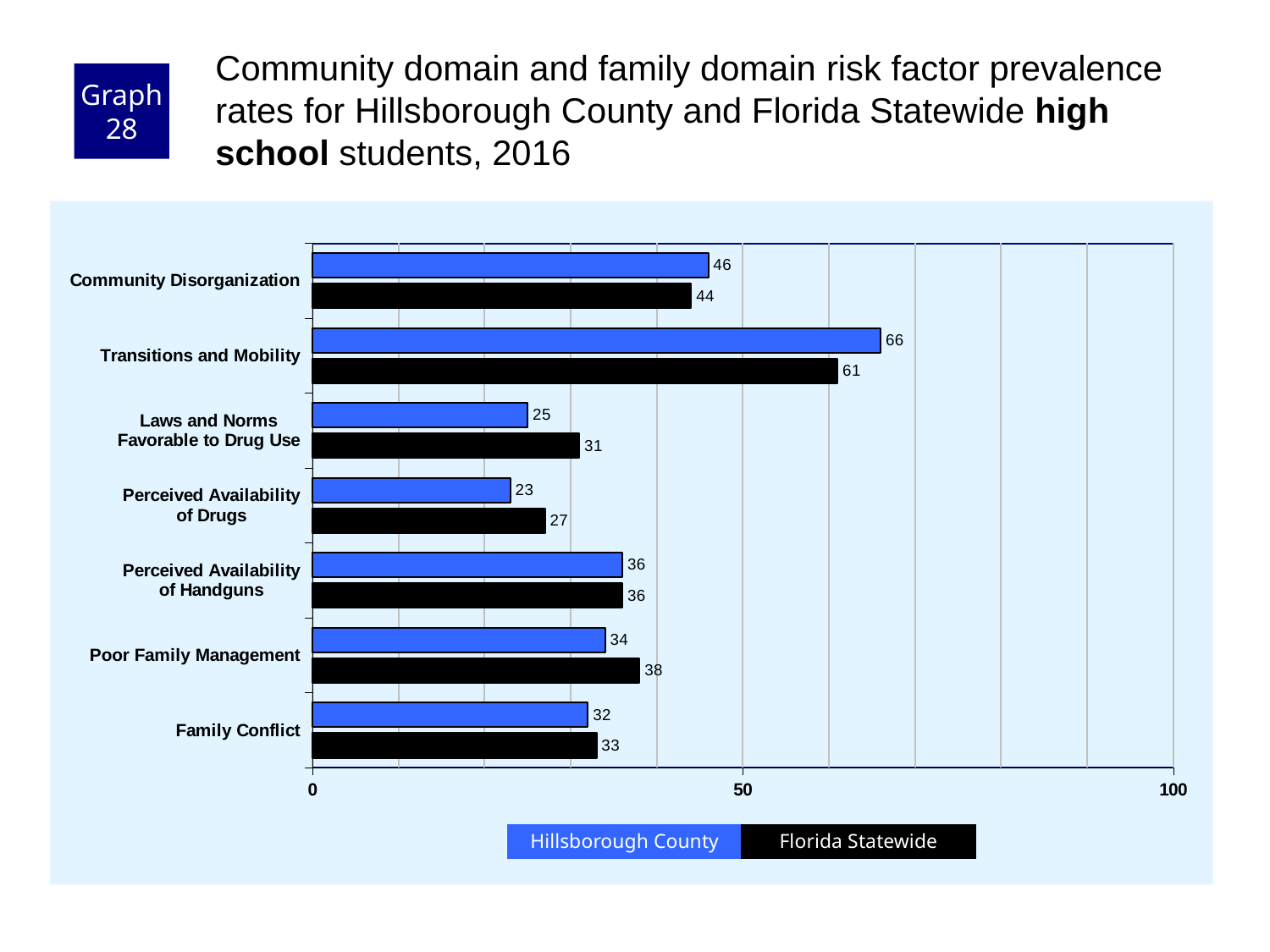
Is the Florida Statewide value for Transitions and Mobility greater or less than 50? greater Which risk factor has the highest Hillsborough County value? Transitions and Mobility What kind of chart is shown on the slide? Bar chart Which risk factor has the lowest Hillsborough County value? Perceived Availability of Drugs What is the Florida Statewide value for Poor Family Management? 38 How many risk factor categories are shown on the chart? 7 What is the difference between the Florida Statewide and Hillsborough County values for Laws and Norms Favorable to Drug Use? 6 What is the difference between the Hillsborough County and Florida Statewide values for Transitions and Mobility? 5 Which is larger for Community Disorganization: the Hillsborough County value or the Florida Statewide value? Hillsborough County What is the Florida Statewide value for Laws and Norms Favorable to Drug Use? 31 How many series does the legend list? 2 What is the Hillsborough County value for Transitions and Mobility? 66